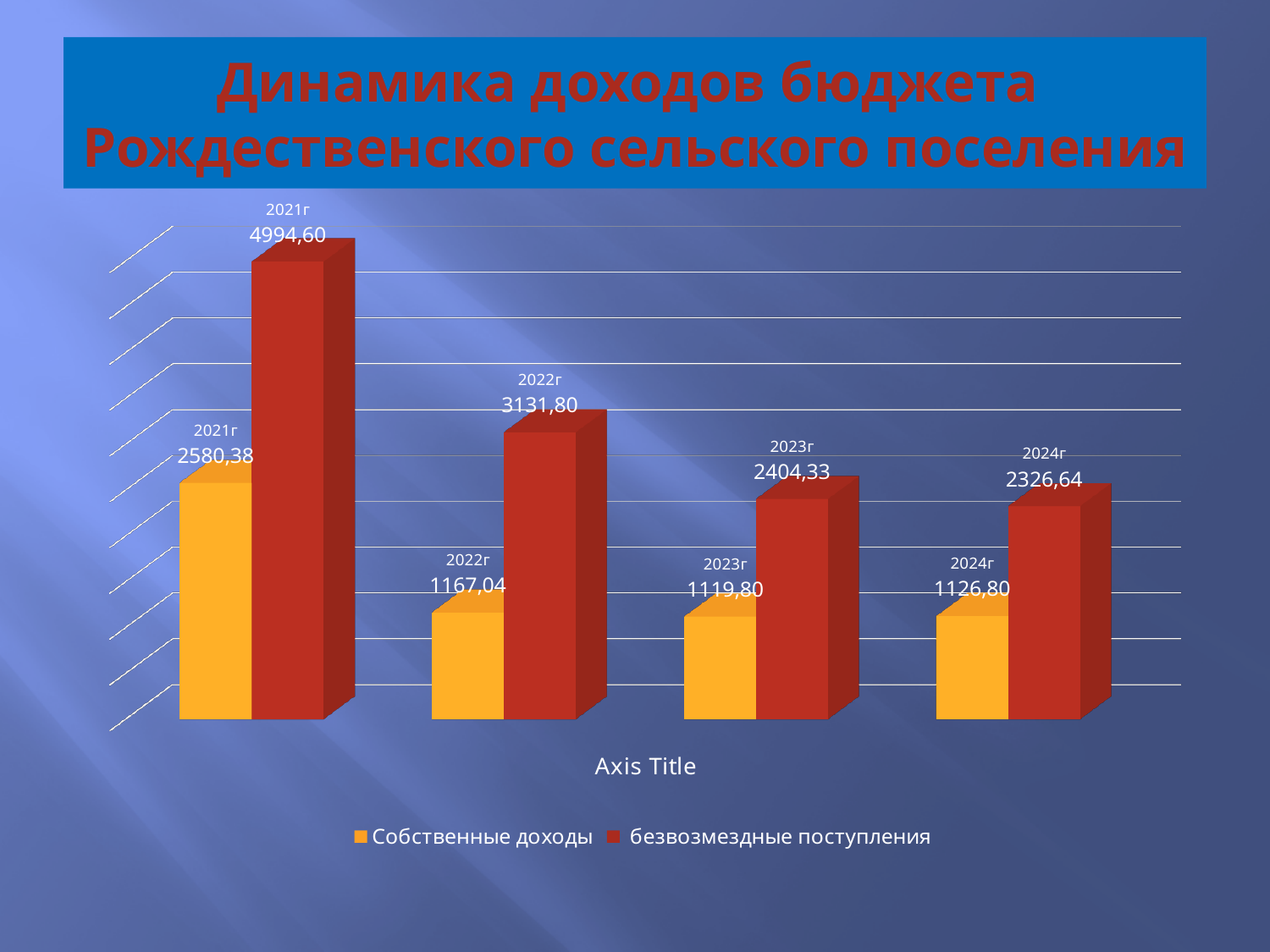
In which year is безвозмездные поступления highest? 2021г How many year categories are shown on the chart? 4 What type of chart is shown on the slide? Bar chart What is the value of безвозмездные поступления for 2024г? 2326,64 Which series is shown in yellow? Собственные доходы Do the values of безвозмездные поступления rise or fall from 2021г to 2024г? Fall What is the value of безвозмездные поступления for 2021г? 4994,60 Which is larger in 2023г: Собственные доходы or безвозмездные поступления? безвозмездные поступления What is the value of Собственные доходы for 2022г? 1167,04 How many series does the legend list? 2 What is the difference between безвозмездные поступления and Собственные доходы in 2021г? 2414,22 In which year is Собственные доходы lowest? 2023г